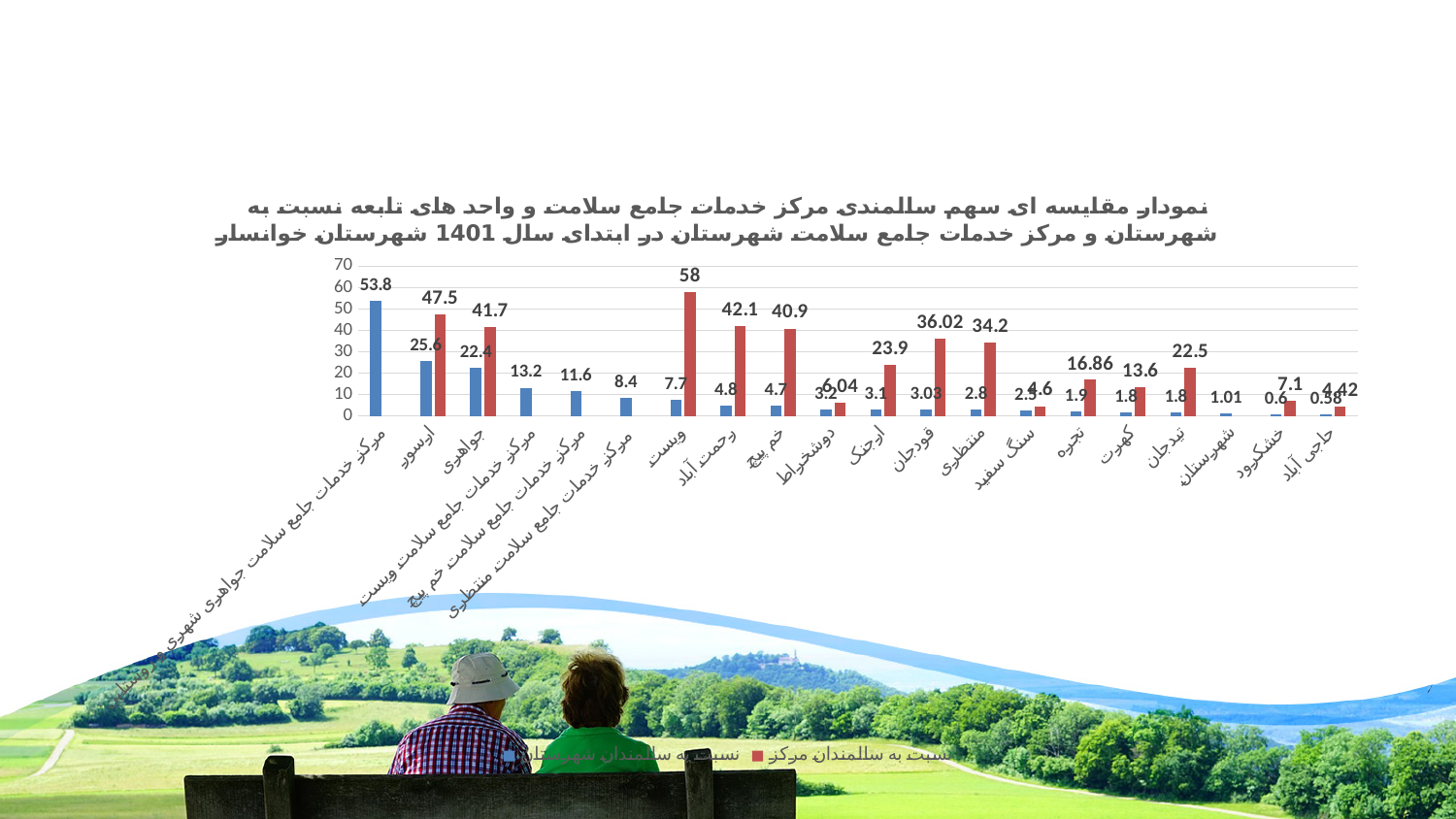
What is the difference between the red and blue values for جواهری? 19.3 Which is larger: the red series value for رحمت آباد or for خم پیچ? رحمت آباد Which category has the lowest value in the blue series (نسبت به سالمندان مرکز)? حاجی آباد What is the value of the red series (نسبت به سالمندان شهرستان) for ویست? 58 What is the value of the blue series (نسبت به سالمندان مرکز) for شهرستان? 1.01 Which category has the highest value in the red series (نسبت به سالمندان شهرستان)? ویست How many series does the legend list? 2 How many categories are shown on the x axis? 20 What is the value of the red series (نسبت به سالمندان شهرستان) for قودجان? 36.02 What kind of chart is shown on the slide? bar chart Which colour represents the series نسبت به سالمندان شهرستان in the legend? red